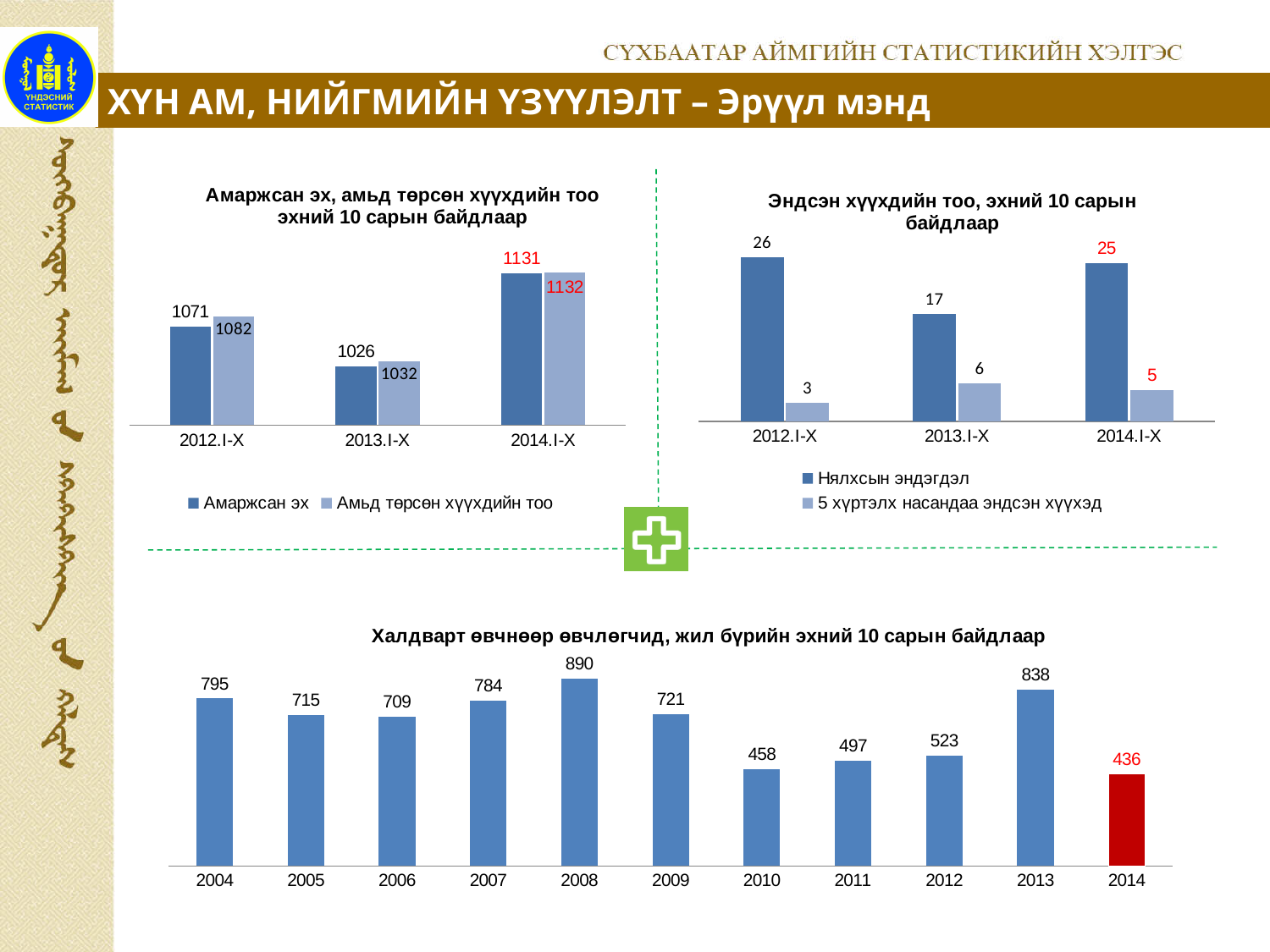
In the bottom chart (Халдварт өвчнөөр өвчлөгчид), which year has the highest value? 2008 In the top-left chart (Амаржсан эх, амьд төрсөн хүүхдийн тоо), what is the difference between Амьд төрсөн хүүхдийн тоо and Амаржсан эх in 2012.I-X? 11 In the top-right chart (Эндсэн хүүхдийн тоо), which period has the highest value of Нялхсын эндэгдэл? 2012.I-X In the top-right chart (Эндсэн хүүхдийн тоо), what is the value of 5 хүртэлх насандаа эндсэн хүүхэд for 2014.I-X? 5 In the top-left chart (Амаржсан эх, амьд төрсөн хүүхдийн тоо), how many series does the legend list? 2 In the top-right chart (Эндсэн хүүхдийн тоо), what is the difference between Нялхсын эндэгдэл and 5 хүртэлх насандаа эндсэн хүүхэд in 2014.I-X? 20 In the top-left chart (Амаржсан эх, амьд төрсөн хүүхдийн тоо), what is the value of Амьд төрсөн хүүхдийн тоо for 2014.I-X? 1132 In the bottom chart (Халдварт өвчнөөр өвчлөгчид), how many years are shown on the x axis? 11 In the bottom chart (Халдварт өвчнөөр өвчлөгчид), what is the value for 2011? 497 In the top-right chart (Эндсэн хүүхдийн тоо), what is the value of Нялхсын эндэгдэл for 2013.I-X? 17 In the top-left chart (Амаржсан эх, амьд төрсөн хүүхдийн тоо), what is the value of Амаржсан эх for 2013.I-X? 1026 In the bottom chart (Халдварт өвчнөөр өвчлөгчид), which year has the lowest value? 2014